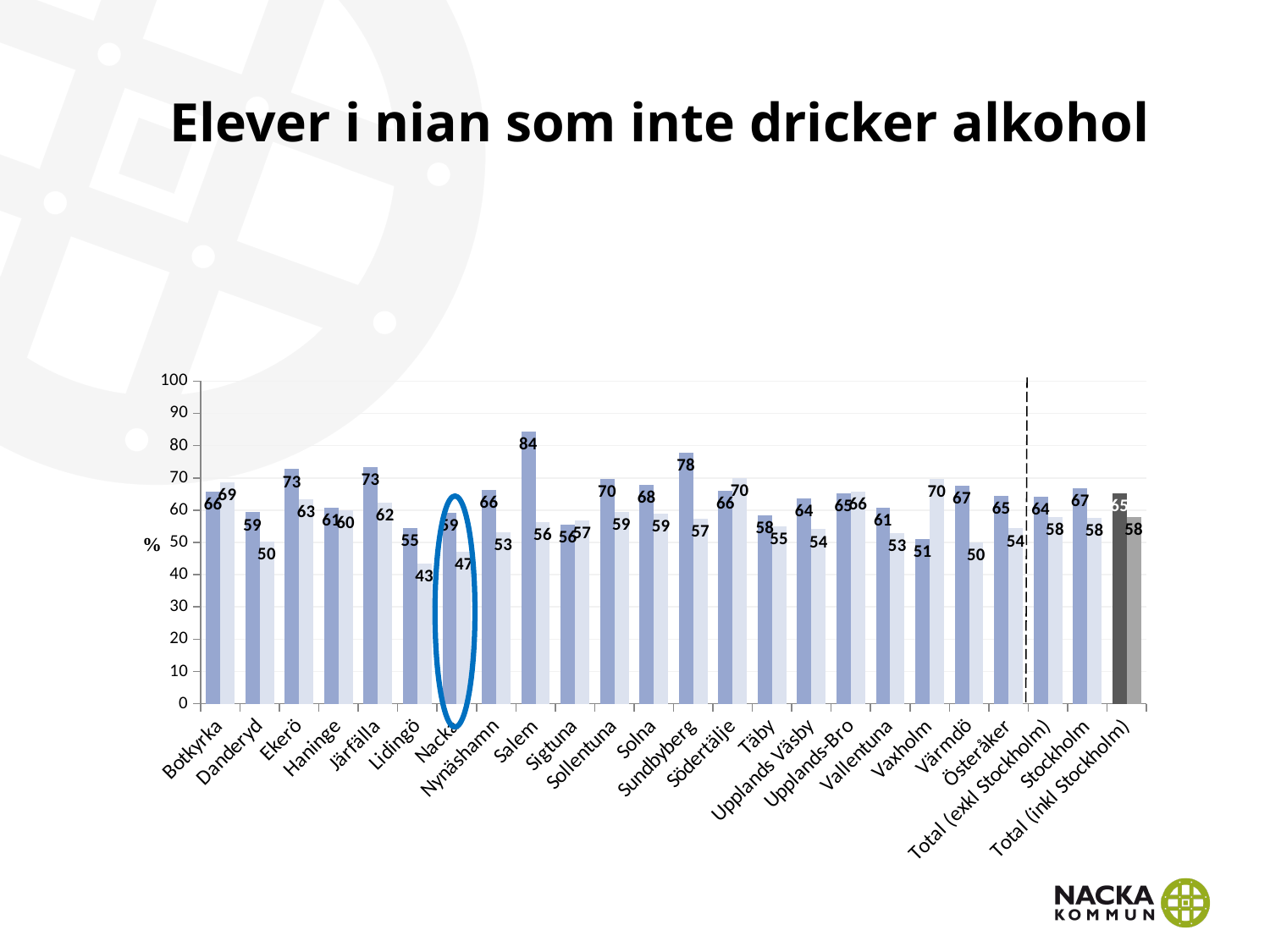
What kind of chart is shown on the slide? bar chart How many categories are shown on the x axis? 24 For Vaxholm, which is larger: the first (darker) bar or the second (lighter) bar? the second (lighter) bar What is the difference between the first (darker) bar and the second (lighter) bar for Sundbyberg? 21 Which category has the lowest value among the second (lighter) bars? Lidingö What is the value of the second (lighter) bar for Lidingö? 43 What is the value of the first (darker) bar for Total (inkl Stockholm)? 65 What is the value of the second (lighter) bar for Nacka, the circled municipality? 47 What is the title of the chart? Elever i nian som inte dricker alkohol What is the value of the first (darker) bar for Salem? 84 Is the first (darker) bar for Salem greater or less than 80? greater Which municipality has the highest value among the first (darker) bars? Salem